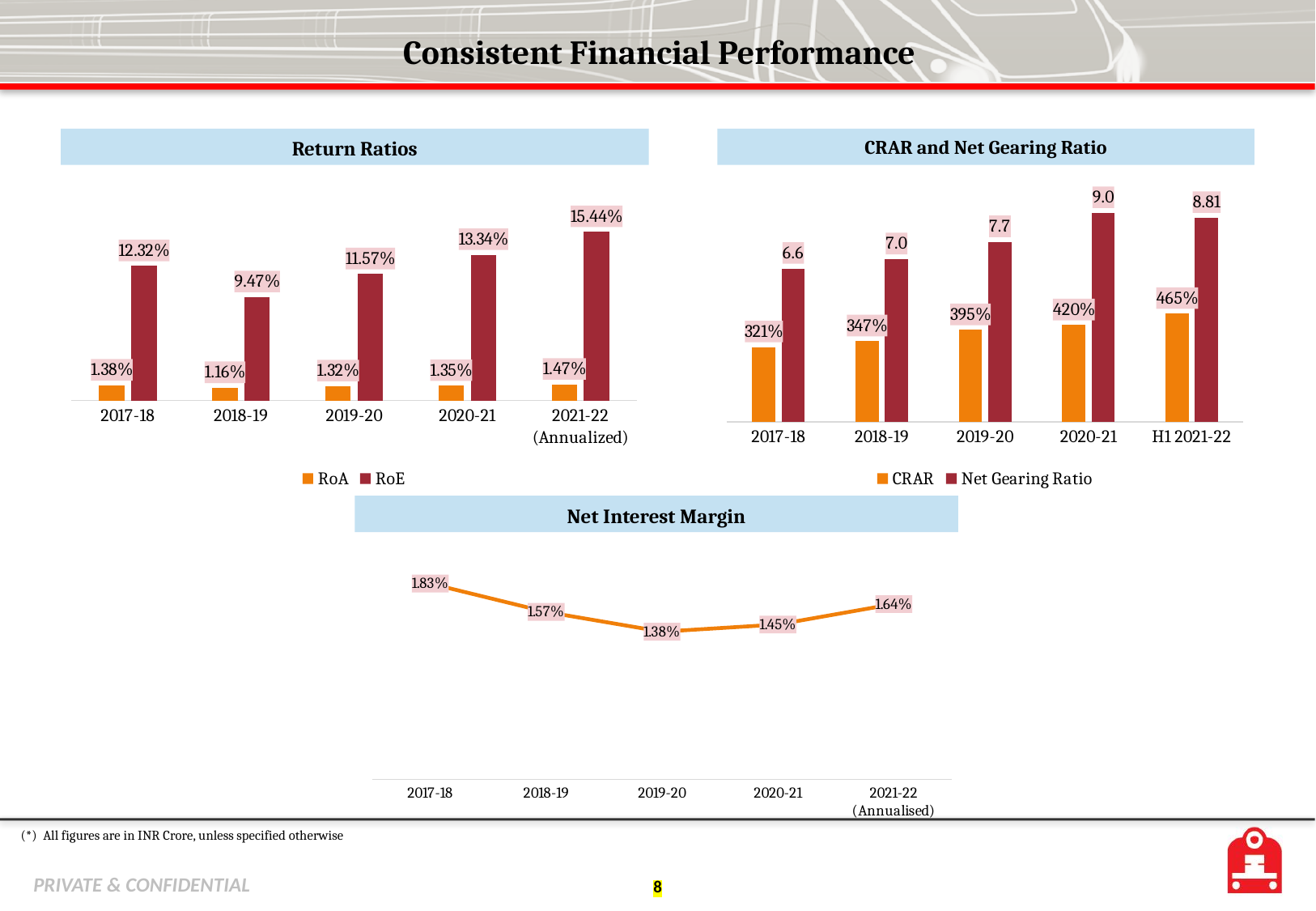
In the Return Ratios chart, which year has the lowest RoA? 2018-19 What kind of chart is the Net Interest Margin chart? line chart In the Net Interest Margin chart, what is the value for 2019-20? 1.38% In the Net Interest Margin chart, does the value rise or fall from 2017-18 to 2019-20? fall In the CRAR and Net Gearing Ratio chart, how many periods are shown on the x axis? 5 In the Return Ratios chart, how many series does the legend list? 2 In the Return Ratios chart, what is the RoE value for 2021-22 (Annualized)? 15.44% In the CRAR and Net Gearing Ratio chart, which period has the highest Net Gearing Ratio? 2020-21 In the Return Ratios chart, what is the difference between RoE in 2020-21 and RoE in 2019-20? 1.77% In the CRAR and Net Gearing Ratio chart, what is the CRAR value for 2019-20? 395% In the CRAR and Net Gearing Ratio chart, is the CRAR for H1 2021-22 larger or smaller than the CRAR for 2020-21? larger In the Net Interest Margin chart, what is the difference between the 2017-18 value and the 2018-19 value? 0.26%